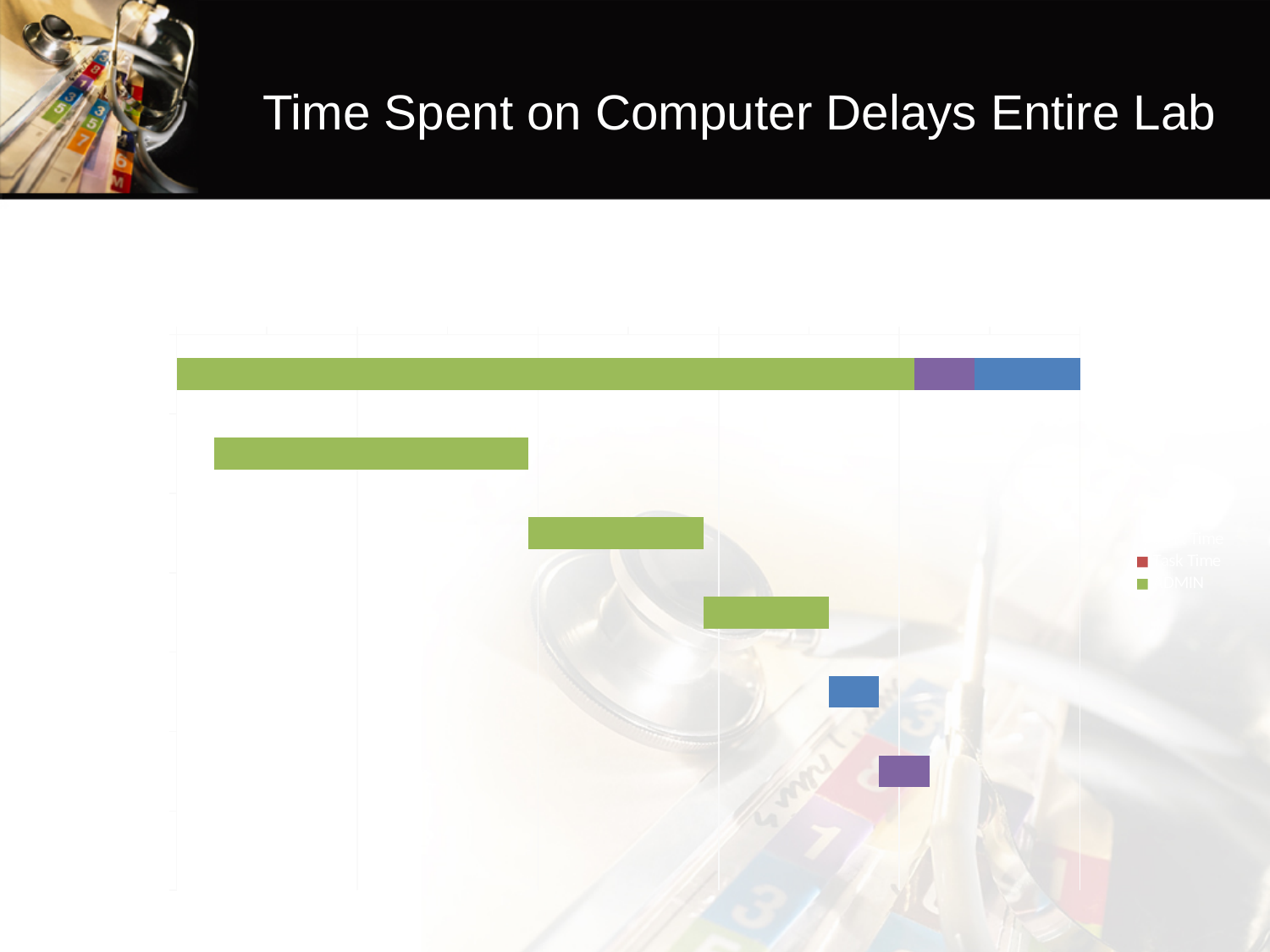
How many different colours are used for the bar segments in the chart? 3 How many bars (rows) are plotted in the chart? 6 What colour is the longest segment of the top bar in the chart? green What kind of chart is shown on the slide? bar chart Which bar in the chart is the longest? the top bar